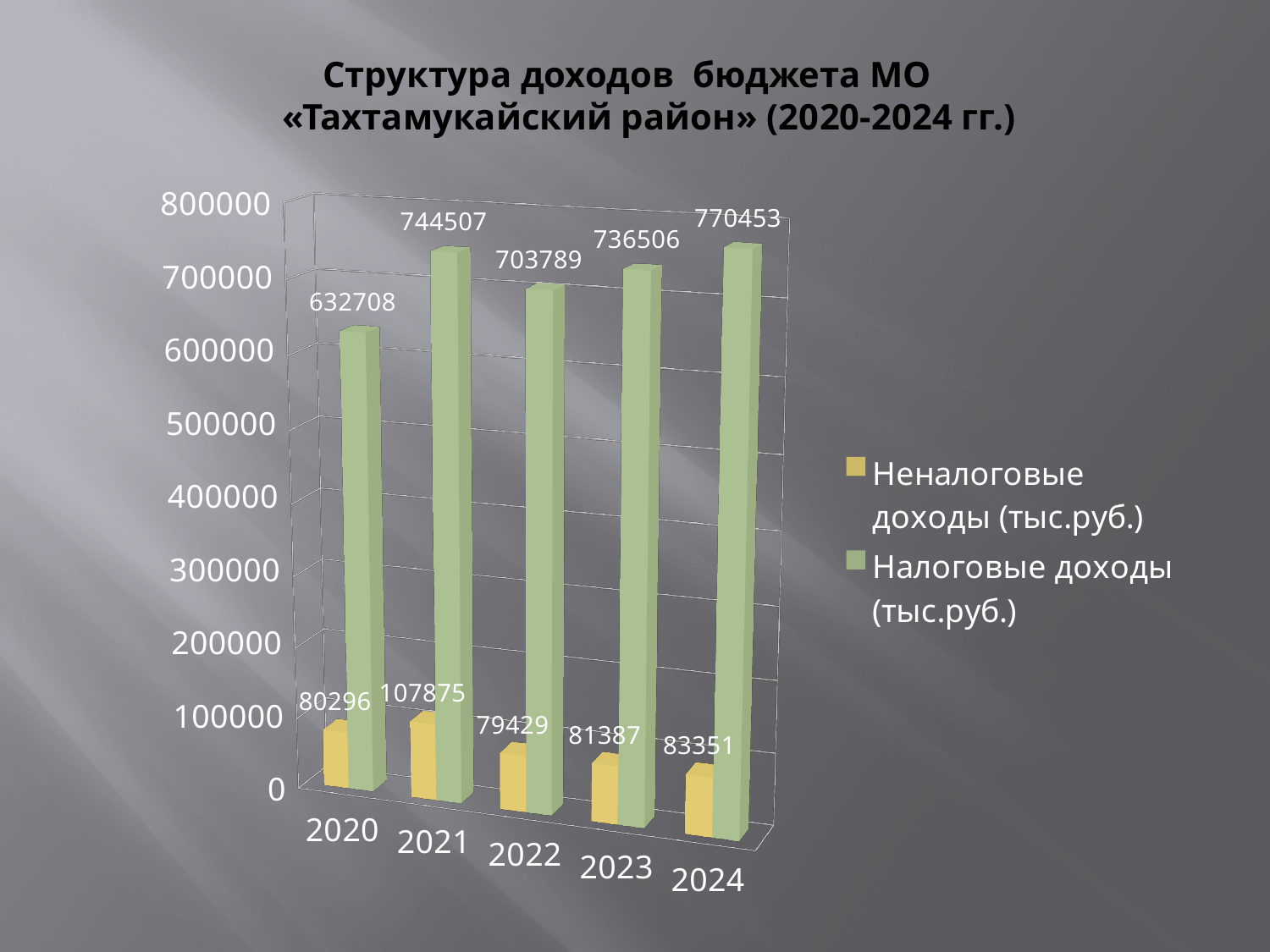
What kind of chart is shown on the slide? bar chart How many series does the legend list? 2 Which year has the lowest value for Неналоговые доходы (тыс.руб.)? 2022 What is the value of Неналоговые доходы (тыс.руб.) for 2021? 107875 Which is larger: Налоговые доходы (тыс.руб.) in 2021 or in 2022? 2021 Which year has the highest value for Налоговые доходы (тыс.руб.)? 2024 What is the value of Налоговые доходы (тыс.руб.) for 2024? 770453 What colour are the bars for Налоговые доходы (тыс.руб.)? green What is the difference between Налоговые доходы (тыс.руб.) in 2024 and in 2020? 137745 What is the value of Налоговые доходы (тыс.руб.) for 2020? 632708 How many years are shown on the x axis of the chart? 5 Is the value for Налоговые доходы (тыс.руб.) in 2023 greater or less than 700000? greater